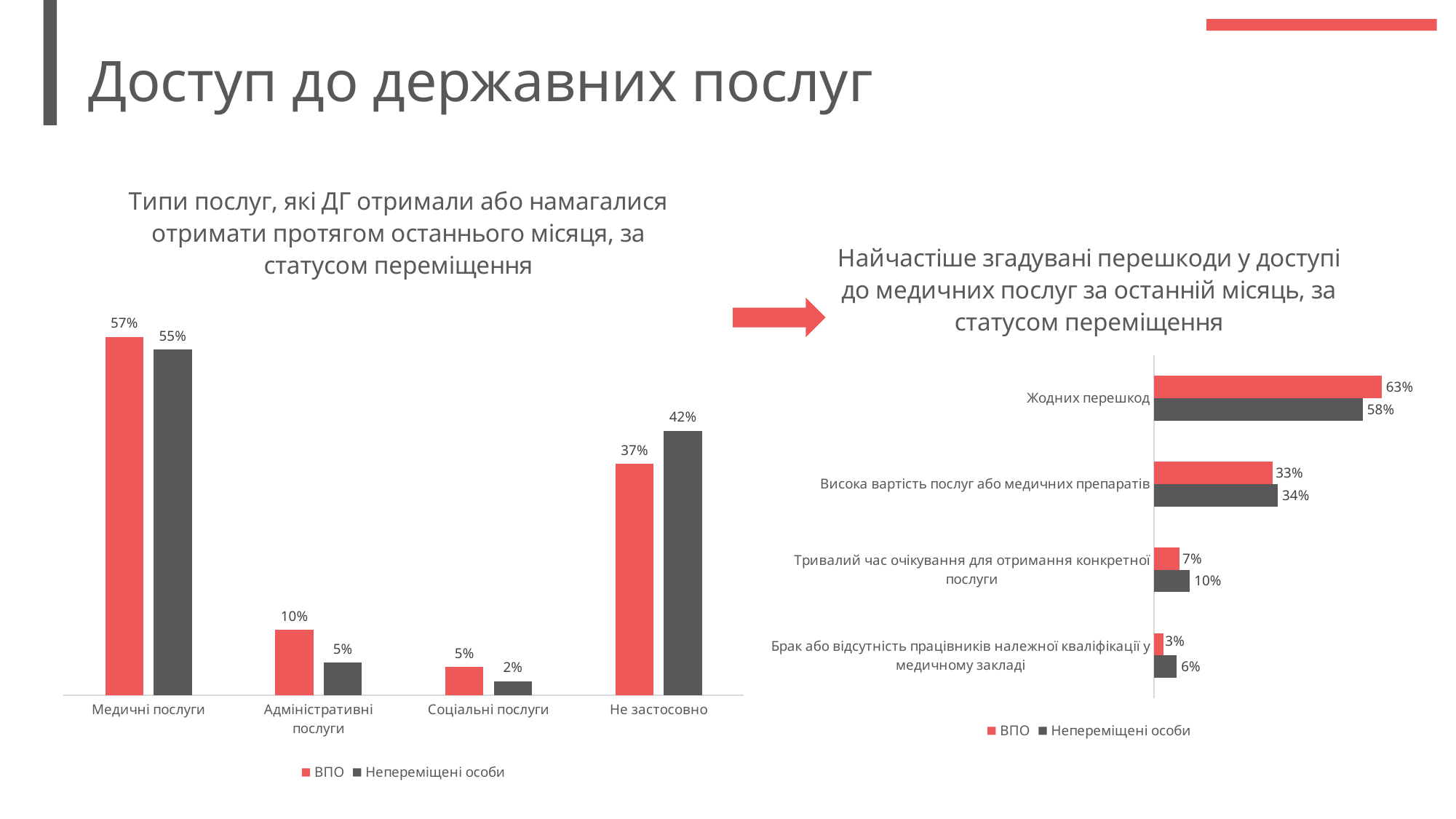
In the right chart (Найчастіше згадувані перешкоди у доступі до медичних послуг), what is the value for ВПО for Жодних перешкод? 63% What type of chart is the right chart? Bar chart In the left chart, which category has the lowest value for Непереміщені особи? Соціальні послуги In the left chart, what is the difference between ВПО and Непереміщені особи for Адміністративні послуги? 5% In the left chart, which is larger for Не застосовно: ВПО or Непереміщені особи? Непереміщені особи In the left chart, what is the value for Непереміщені особи for Не застосовно? 42% In the right chart, what is the difference between Непереміщені особи and ВПО for Брак або відсутність працівників належної кваліфікації у медичному закладі? 3% In the left chart (Типи послуг, які ДГ отримали або намагалися отримати протягом останнього місяця), what is the value for ВПО for Медичні послуги? 57% How many series does the legend of the right chart list? 2 How many categories are shown on the x axis of the left chart? 4 In the right chart, what is the value for Непереміщені особи for Тривалий час очікування для отримання конкретної послуги? 10% In the right chart, which category has the highest value for ВПО? Жодних перешкод